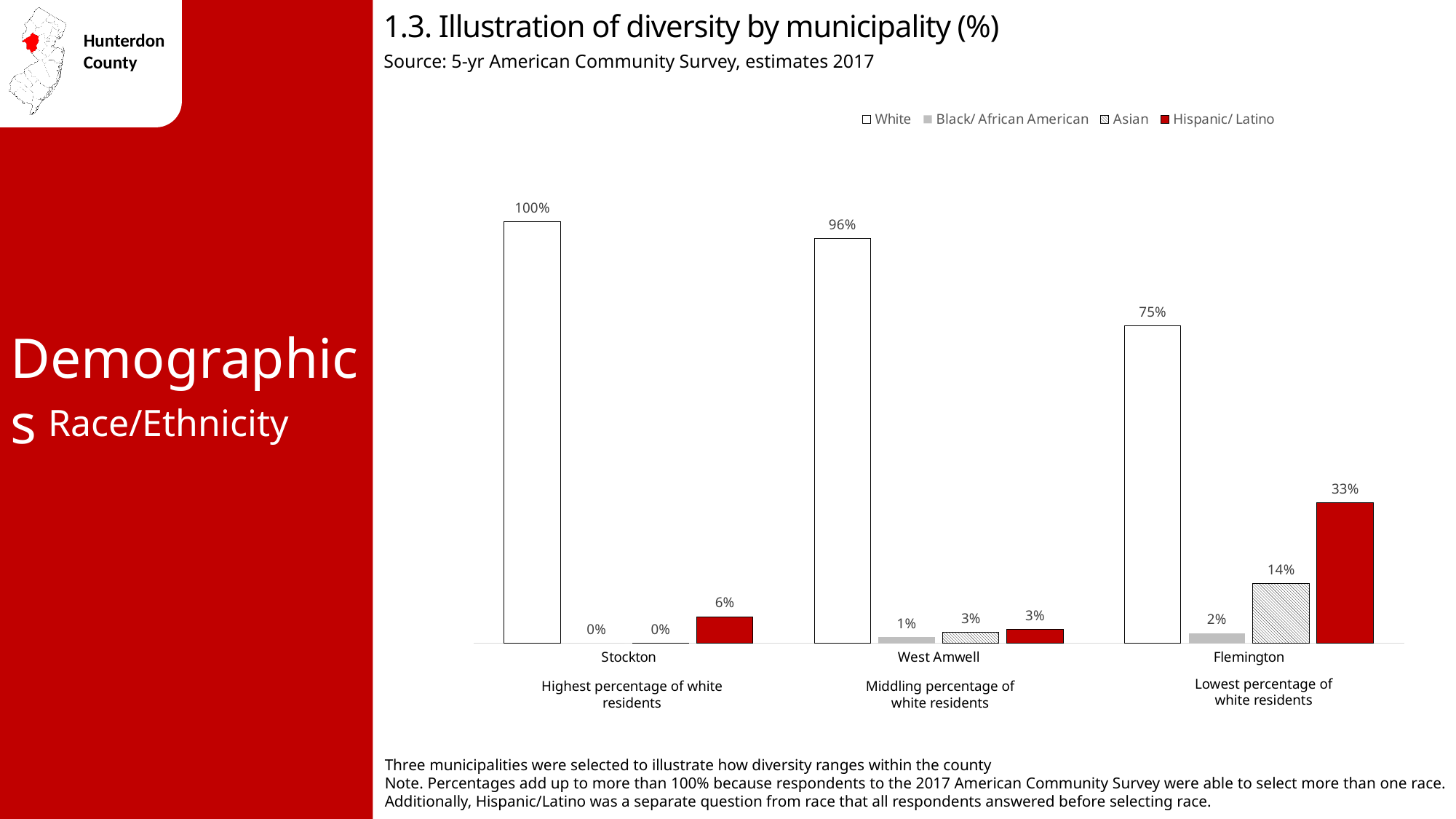
What is the Black/African American percentage for Flemington? 2% Which municipality has the lowest White percentage? Flemington What is the Asian percentage for West Amwell? 3% What is the Hispanic/Latino percentage for Flemington? 33% What is the source cited for the chart data? 5-yr American Community Survey, estimates 2017 How many municipalities are shown on the chart? 3 What is the difference between the White percentage in Stockton and in Flemington? 25% Which municipality has the highest Hispanic/Latino percentage? Flemington How many series does the legend list? 4 What percentage of Stockton residents are White? 100% Is the Asian percentage higher in Flemington or in West Amwell? Flemington What type of chart is shown? Bar chart